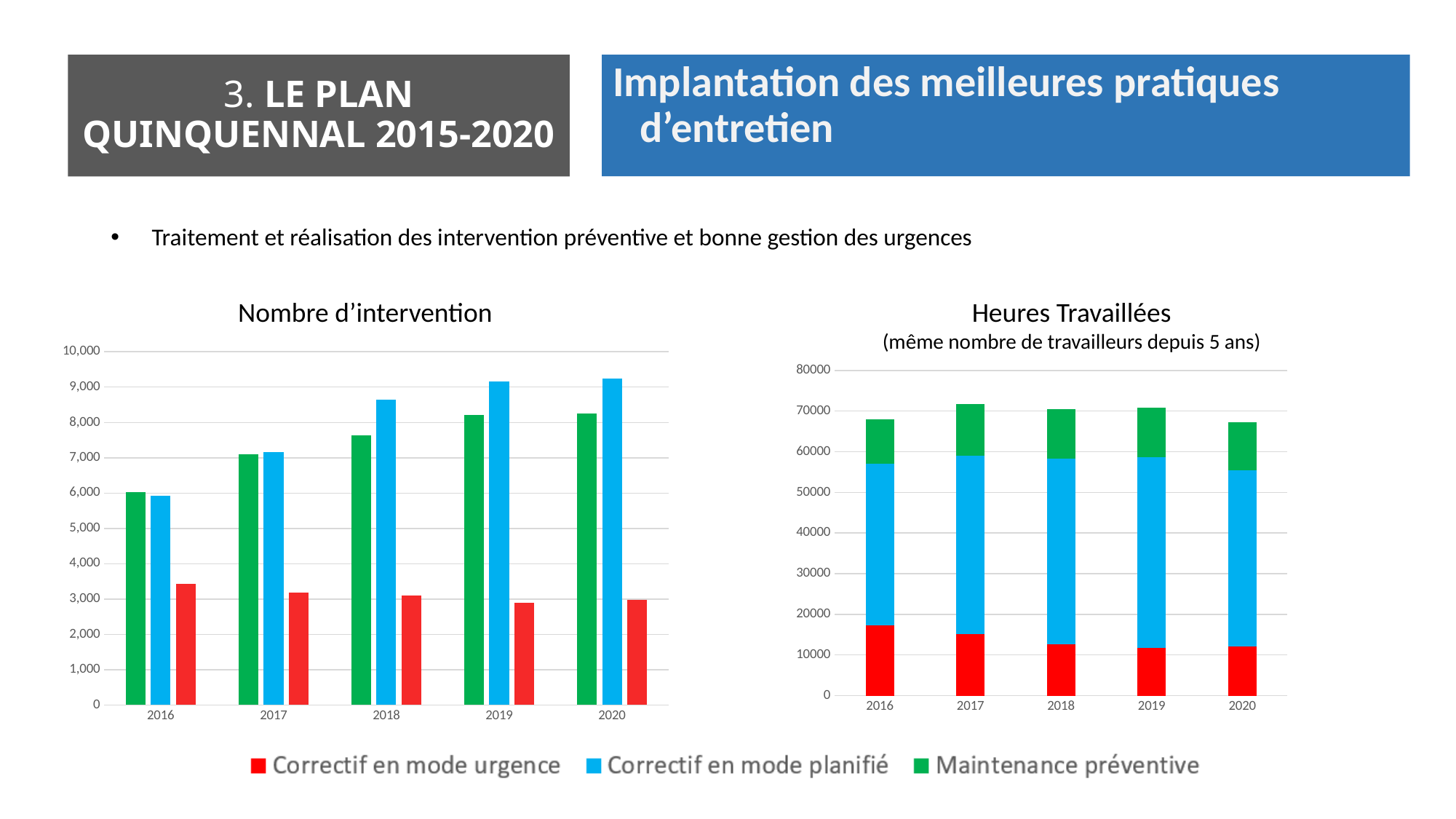
In the "Nombre d'intervention" chart, is the value for Correctif en mode planifié in 2019 greater or less than 9,000? greater In the "Nombre d'intervention" chart, is the value for Correctif en mode urgence in 2016 greater or less than 3,000? greater What kind of chart is the "Heures Travaillées" chart? stacked bar chart In the "Heures Travaillées" chart, is the total stacked bar for 2017 greater or less than 70000? greater In the "Nombre d'intervention" chart, which year has the lowest value for Maintenance préventive? 2016 How many series does the legend list? 3 In the "Nombre d'intervention" chart, which is larger in 2018: Correctif en mode planifié or Maintenance préventive? Correctif en mode planifié What kind of chart is the "Nombre d'intervention" chart? bar chart In the "Nombre d'intervention" chart, do the values for Correctif en mode planifié rise or fall from 2016 to 2020? rise How many years are shown on the x axis of the "Nombre d'intervention" chart? 5 In the "Nombre d'intervention" chart, which year has the highest value for Correctif en mode urgence? 2016 In the "Heures Travaillées" chart, which colour represents Correctif en mode urgence? red